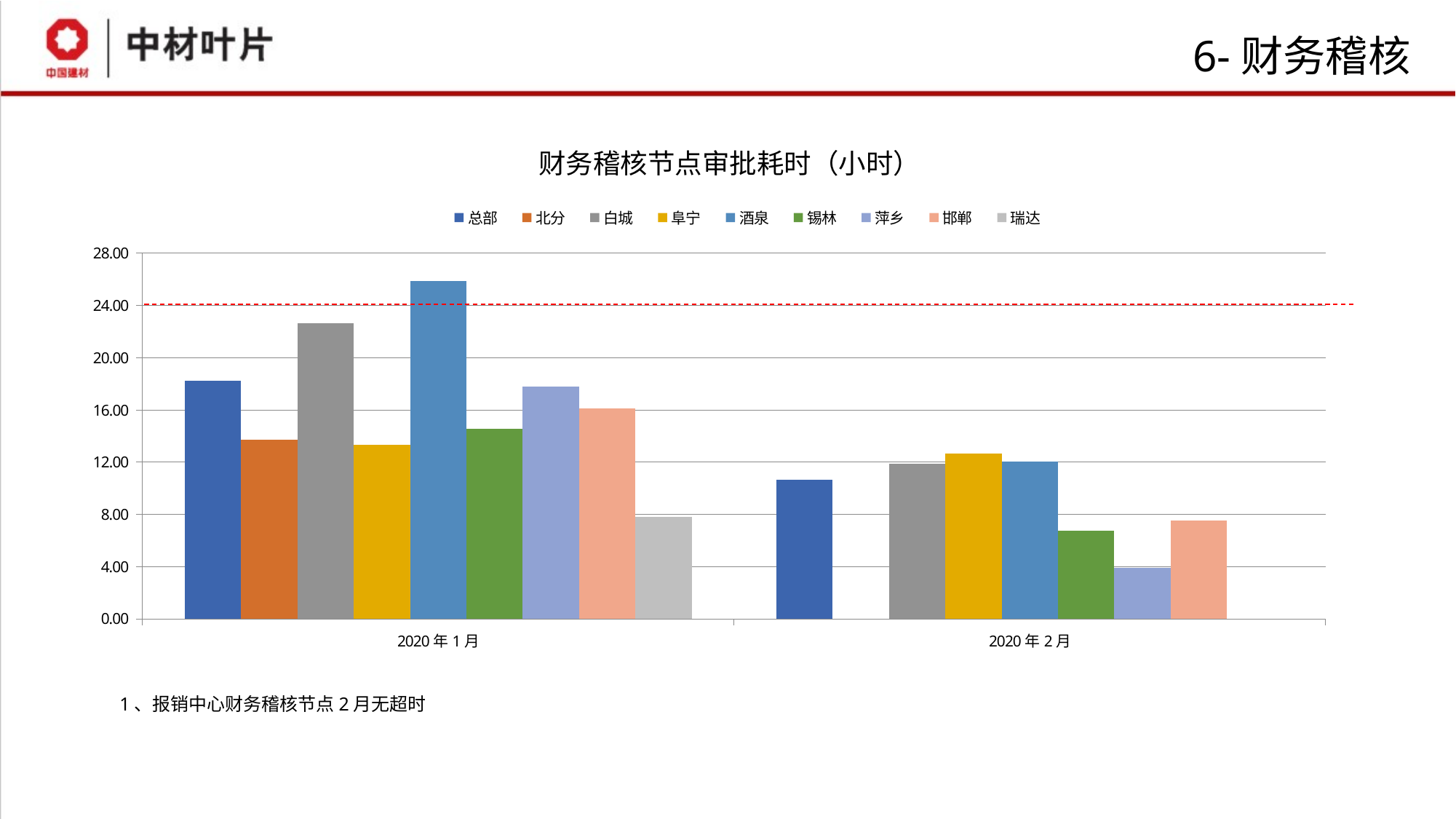
Is the value for 酒泉 in 2020年1月 greater or less than 24.00? greater Which series has the highest value in 2020年1月? 酒泉 Is the value for 锡林 in 2020年2月 greater or less than 8.00? less What kind of chart is shown on the slide? bar chart In 2020年1月, which is larger, the value for 总部 or the value for 北分? 总部 Does the value for 总部 rise or fall from 2020年1月 to 2020年2月? fall What is the title of the chart? 财务稽核节点审批耗时（小时） Which series has the lowest value in 2020年1月? 瑞达 Which series has the lowest value in 2020年2月? 萍乡 How many categories are shown on the x axis? 2 How many series does the legend list? 9 At what value on the y axis is the red dashed horizontal line drawn? 24.00